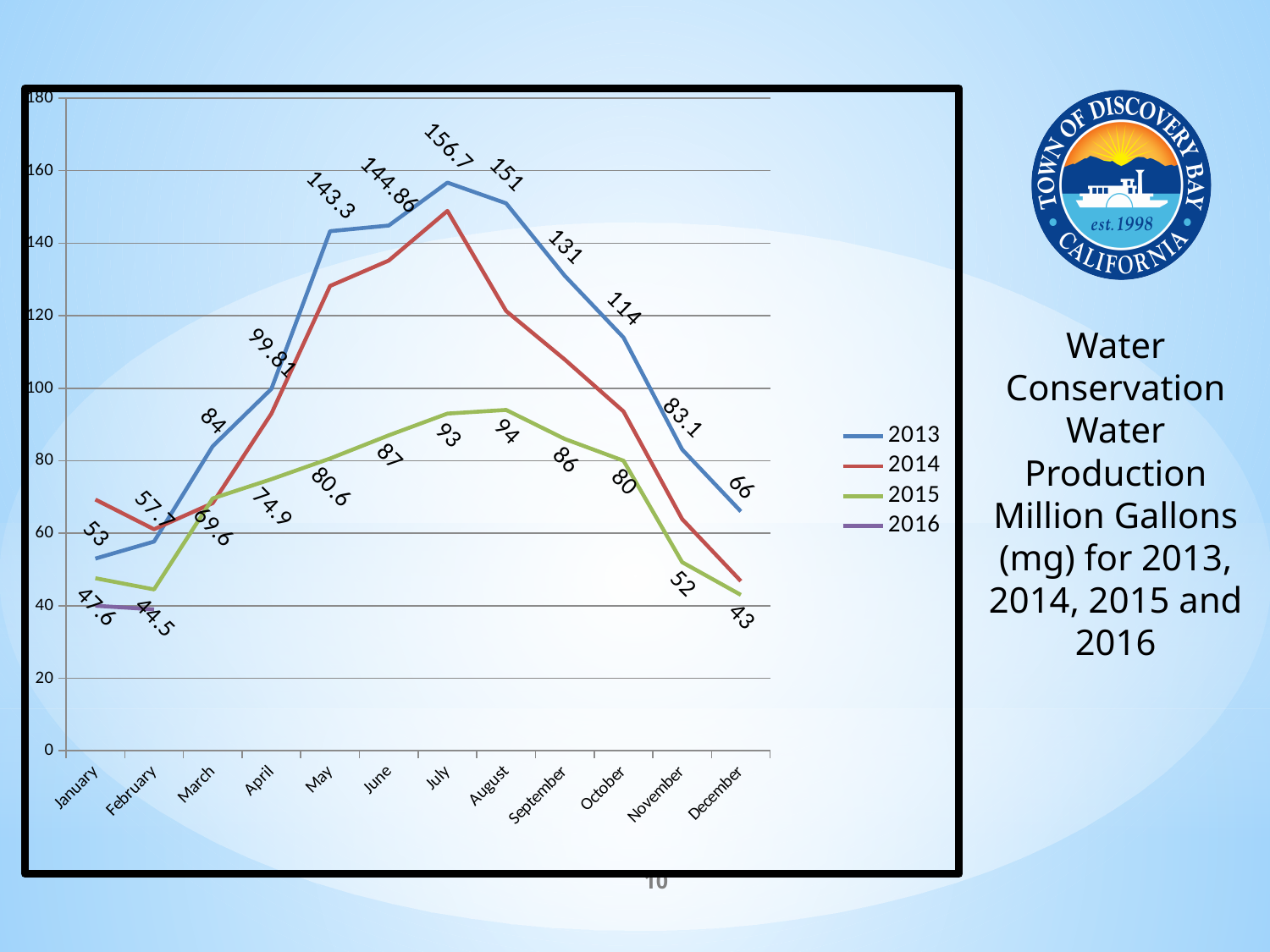
Which is larger, the 2013 value for October or the 2013 value for November? October How many series does the legend list? 4 What is the difference between the 2013 values for July and December? 90.7 Which month has the lowest value in the 2015 series? December What is the value for August in the 2015 series? 94 Which month has the highest value in the 2013 series? July What is the value for December in the 2015 series? 43 What is the value for May in the 2013 series? 143.3 What is the value for July in the 2013 series? 156.7 Is the 2014 value for July greater or less than 140? greater What type of chart is shown on the slide? line chart How many months are shown on the x axis? 12